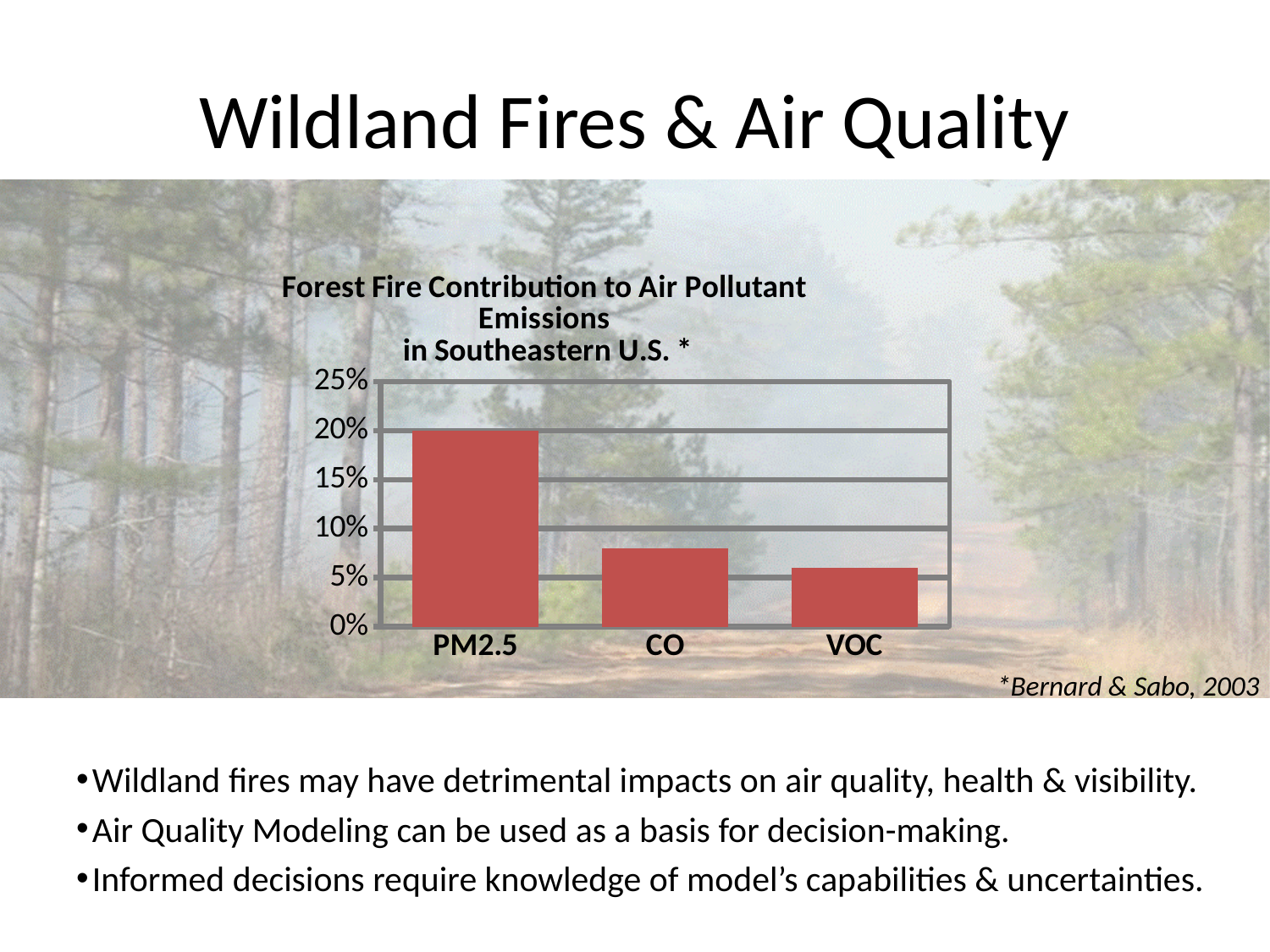
Which has a larger forest fire contribution, CO or VOC? CO Which has a larger forest fire contribution, PM2.5 or CO? PM2.5 Which pollutant has the highest forest fire contribution in the chart? PM2.5 Is the value for CO greater or less than 5%? greater Is the value for VOC greater or less than 10%? less Is the value for CO greater or less than 10%? less Which pollutant has the lowest forest fire contribution in the chart? VOC How many pollutant categories are shown in the chart? 3 What is the title of the chart? Forest Fire Contribution to Air Pollutant Emissions in Southeastern U.S. * What kind of chart is shown on the slide? Bar chart What is the forest fire contribution to PM2.5 emissions shown in the chart? 20% Do the values rise or fall from PM2.5 to VOC along the x axis? Fall